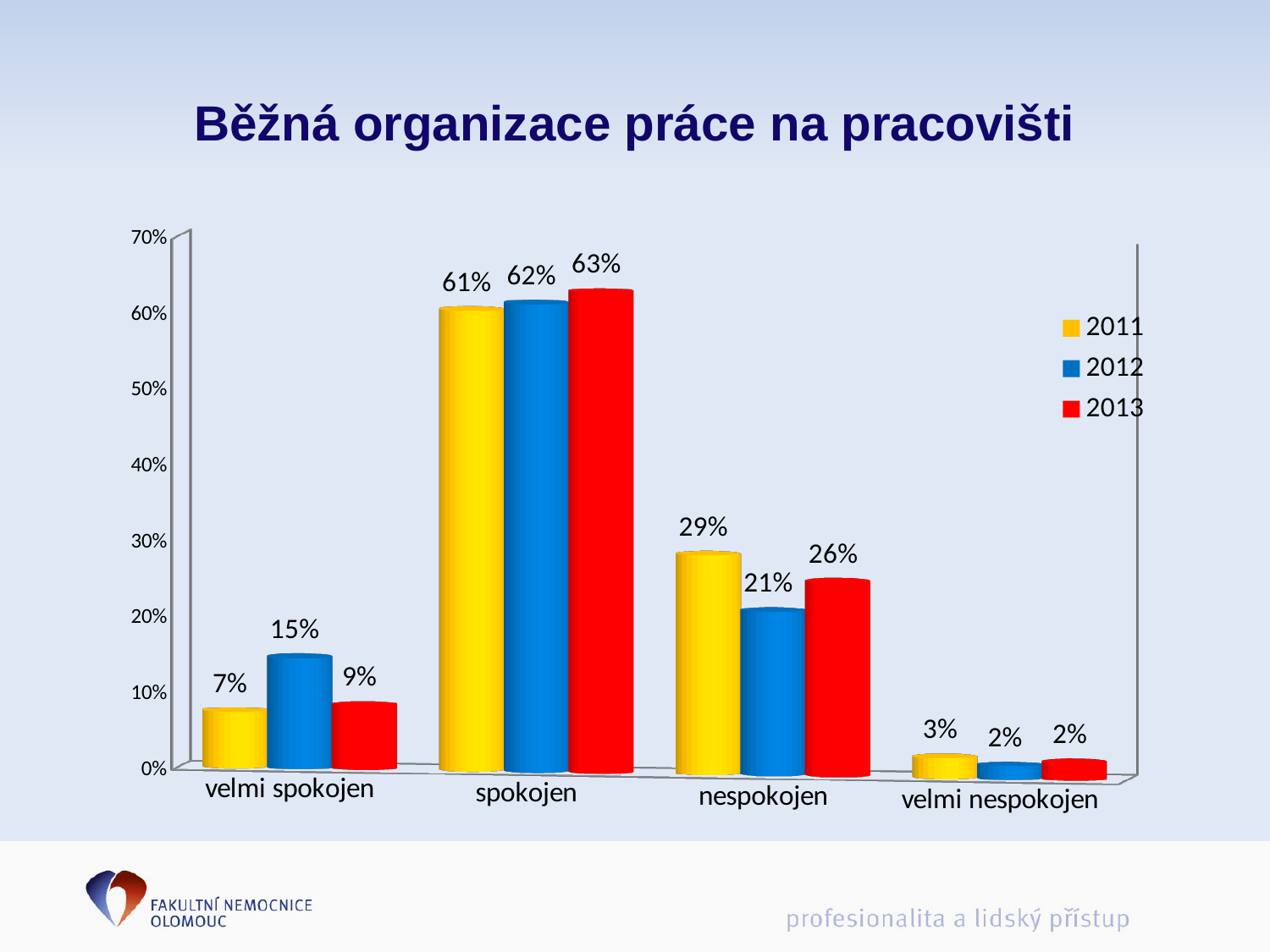
What is the value for 'spokojen' in 2013? 63% How many series does the legend list? 3 Which is larger for 'velmi spokojen': the 2012 value or the 2013 value? 2012 What is the value for 'nespokojen' in 2011? 29% How many categories are shown on the x axis? 4 What is the value for 'velmi spokojen' in 2012? 15% What is the title of the chart? Běžná organizace práce na pracovišti Which category has the highest value in 2012? spokojen Which colour represents the 2013 series? red What kind of chart is shown on the slide? bar chart Which category has the lowest value in 2011? velmi nespokojen What is the difference between the 2011 and 2012 values for 'nespokojen'? 8%